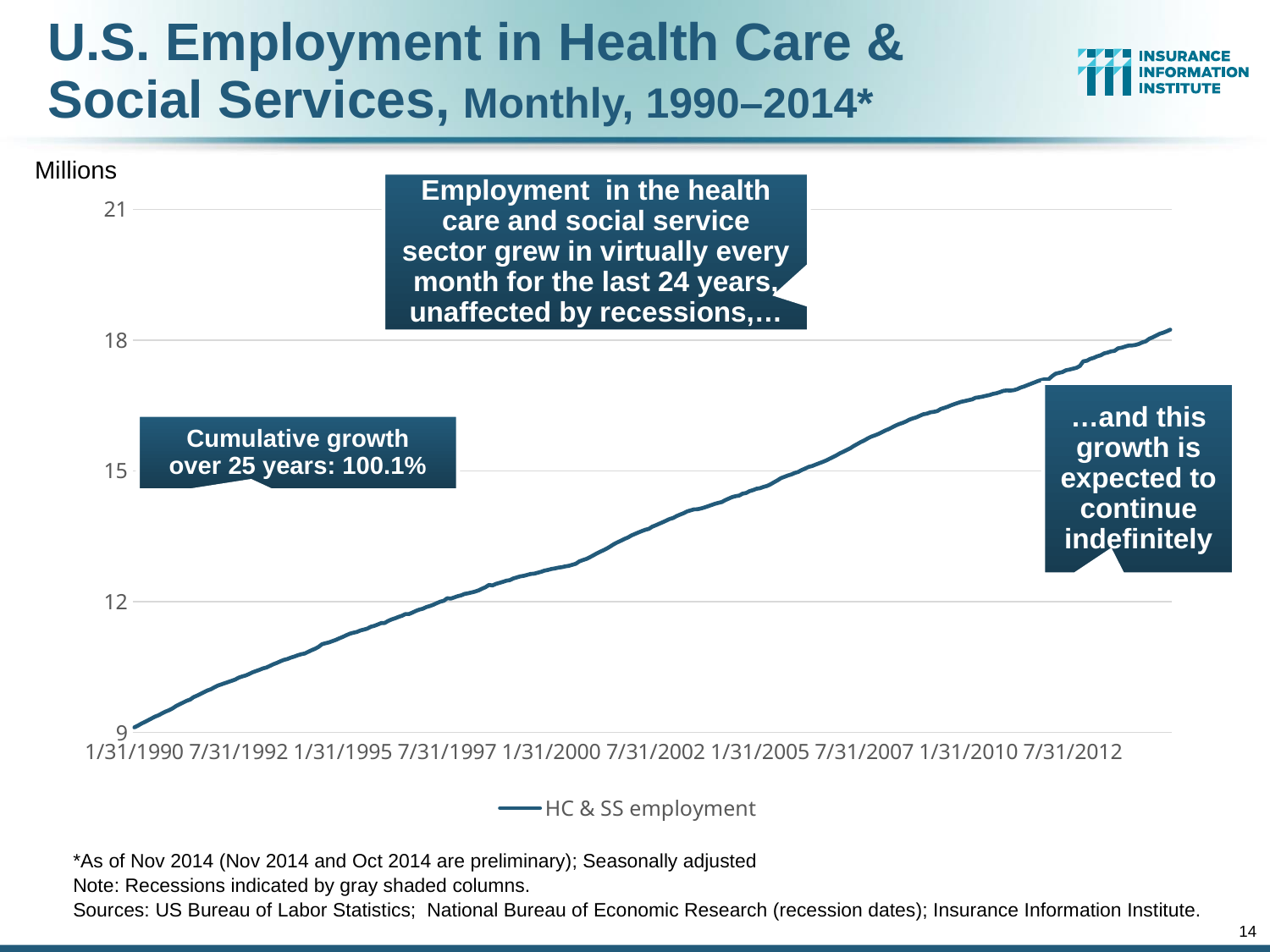
How many date labels are shown on the x axis? 10 What kind of chart is shown on the slide? Line chart Is the value for HC & SS employment at 1/31/2010 greater or less than 15? greater Is the value for HC & SS employment at 1/31/1990 greater or less than 12? less How many series does the legend list? 1 What is the name of the series shown in the legend? HC & SS employment Does HC & SS employment rise or fall over time along the x axis? Rise Is the value for HC & SS employment at 7/31/2012 greater or less than 15? greater What unit is shown for the y axis? Millions At which end of the time period is HC & SS employment highest, the start (1990) or the end (2014)? The end (2014)